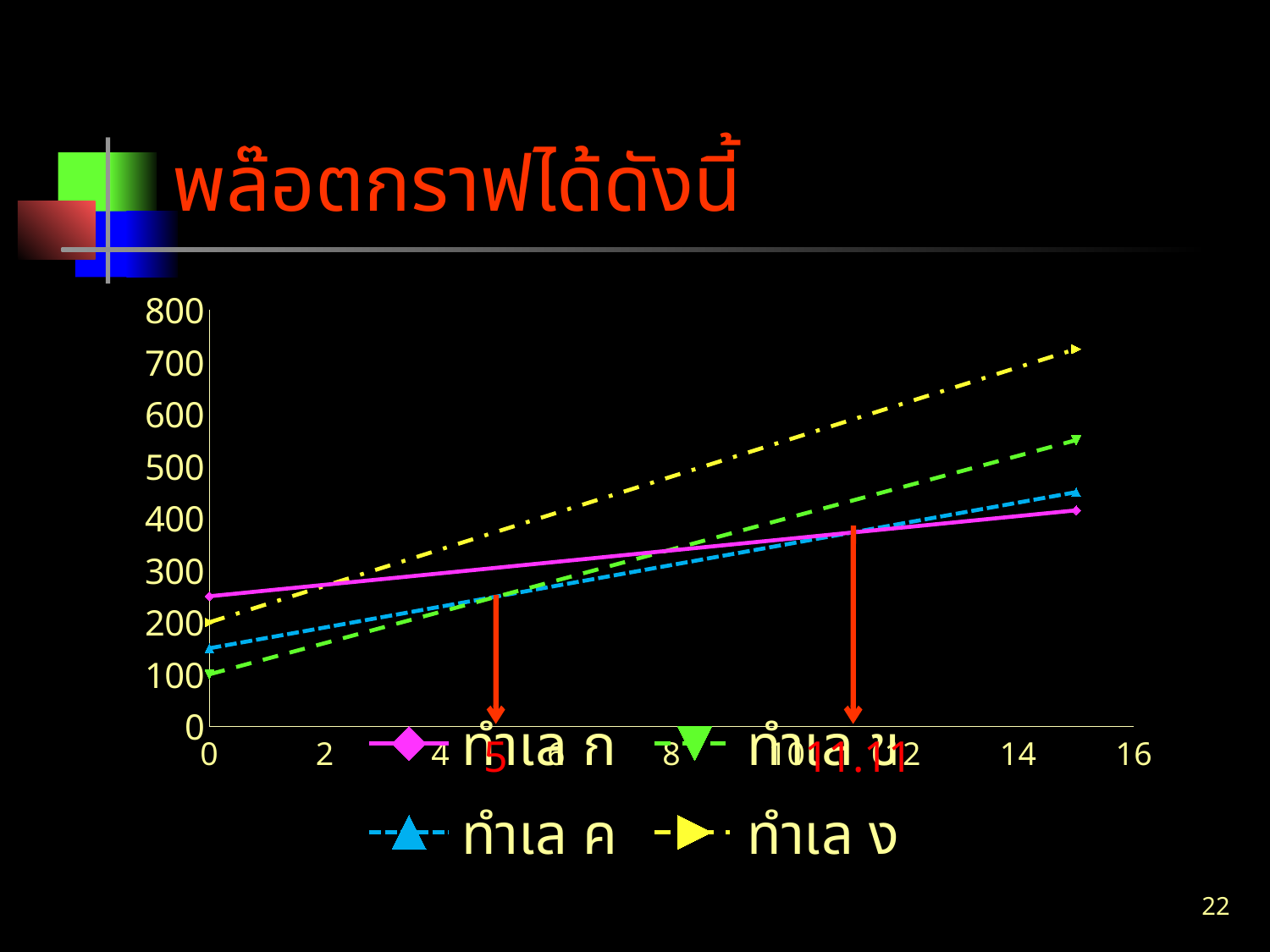
At x = 10, which is larger: ทำเล ข or ทำเล ค? ทำเล ข What is the value of ทำเล ข at x = 0? 100 Which series has the highest value at x = 0? ทำเล ก Is the value for ทำเล ง at x = 14 greater or less than 600? greater Is the value for ทำเล ก at x = 15 greater or less than 500? less What kind of chart is shown on the slide? line chart What are the four series names listed in the legend? ทำเล ก, ทำเล ข, ทำเล ค, ทำเล ง Does the ทำเล ง line rise or fall as x increases? rise Which series has the lowest value at the right end of the chart (x = 15)? ทำเล ก Which series has the lowest value at x = 0? ทำเล ข Which series has the highest value at the right end of the chart (x = 15)? ทำเล ง How many series does the legend list? 4